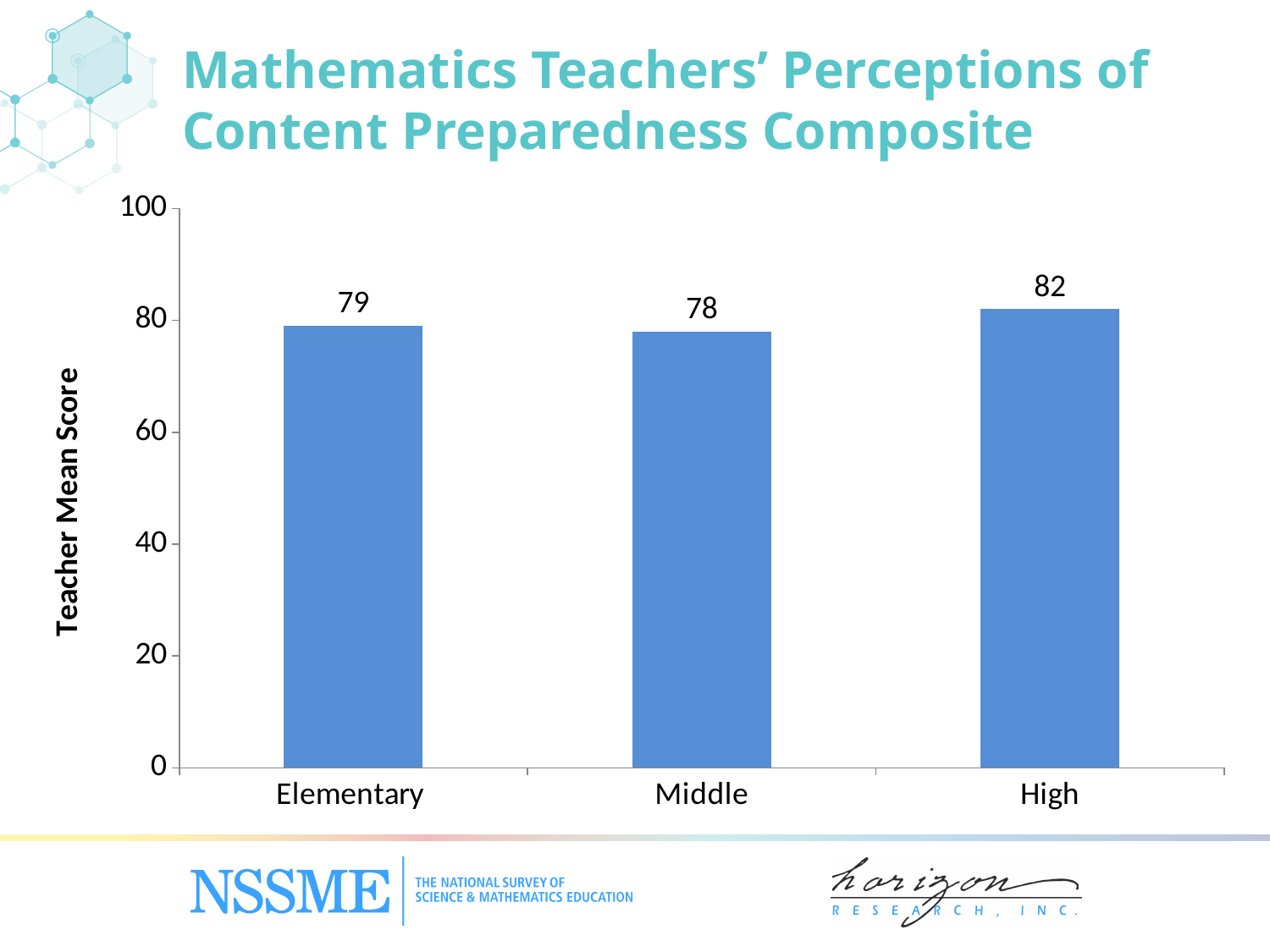
Which has a higher teacher mean score, High or Elementary? High What is the teacher mean score for Middle? 78 Which grade level has the lowest teacher mean score? Middle What is the teacher mean score for High? 82 What is the difference between the teacher mean scores for High and Middle? 4 What kind of chart is shown on the slide? bar chart How many grade-level categories are shown on the x axis? 3 Is the value for Middle greater or less than 80? less Which grade level has the highest teacher mean score? High What is the teacher mean score for Elementary? 79 What is the difference between the teacher mean scores for Elementary and Middle? 1 What is the label of the vertical axis? Teacher Mean Score